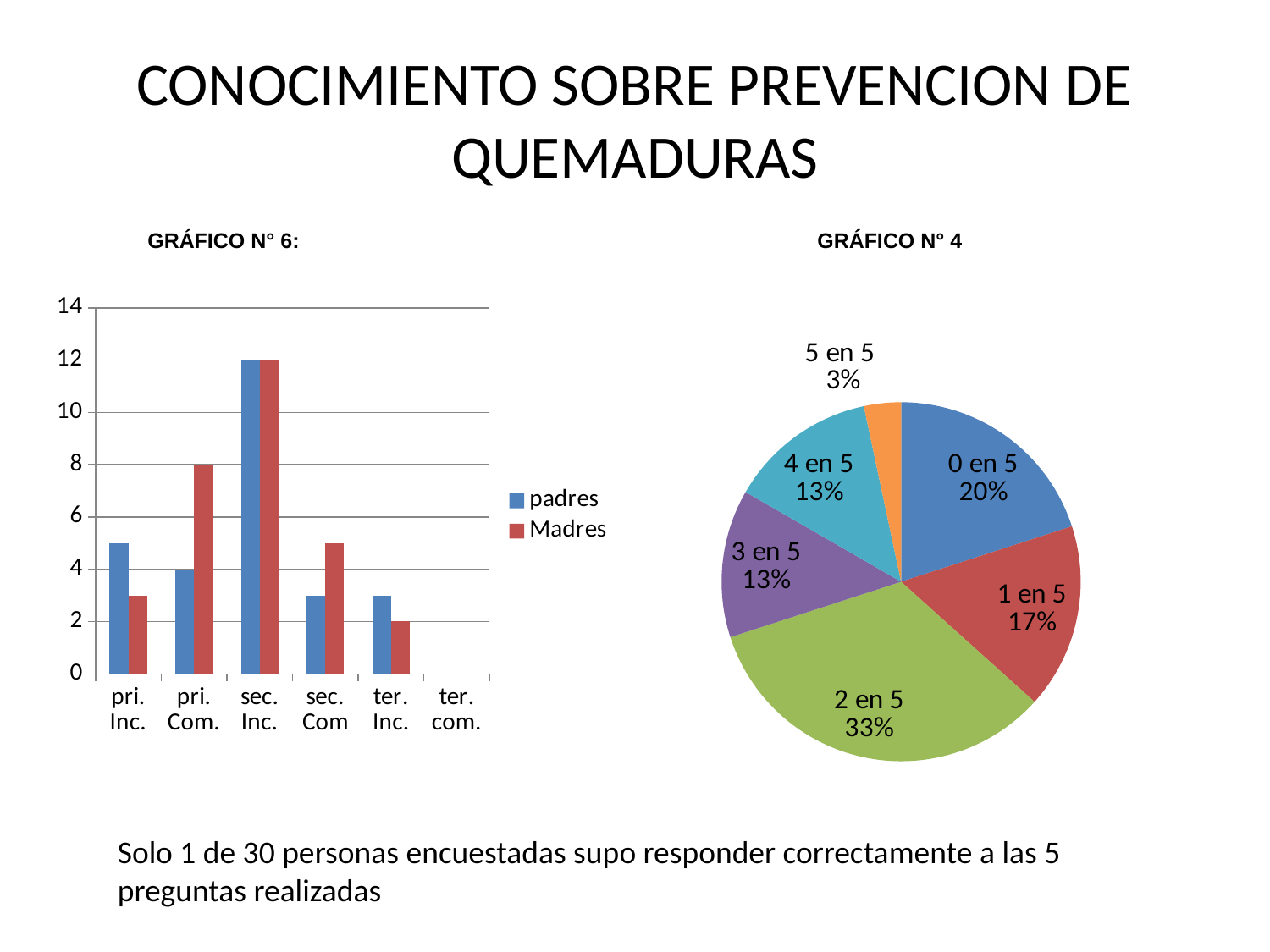
In GRÁFICO N° 4, what share of the pie is the 2 en 5 slice? 33% In GRÁFICO N° 6, which is larger in the pri. Com. category, padres or Madres? Madres In GRÁFICO N° 6, what is the value for Madres in the ter. Inc. category? 2 What kind of chart is GRÁFICO N° 6 on the left of the slide? bar chart In GRÁFICO N° 6, what is the value for Madres in the pri. Com. category? 8 In GRÁFICO N° 6, what is the value for padres in the sec. Inc. category? 12 In GRÁFICO N° 6, how many series does the legend list? 2 What kind of chart is GRÁFICO N° 4 on the right of the slide? pie chart In GRÁFICO N° 4, what is the difference between the 0 en 5 share and the 1 en 5 share? 3% In GRÁFICO N° 6, which category has the highest value for padres? sec. Inc. In GRÁFICO N° 6, is the value for padres in the pri. Inc. category greater or less than 4? greater In GRÁFICO N° 4, which slice is the smallest? 5 en 5